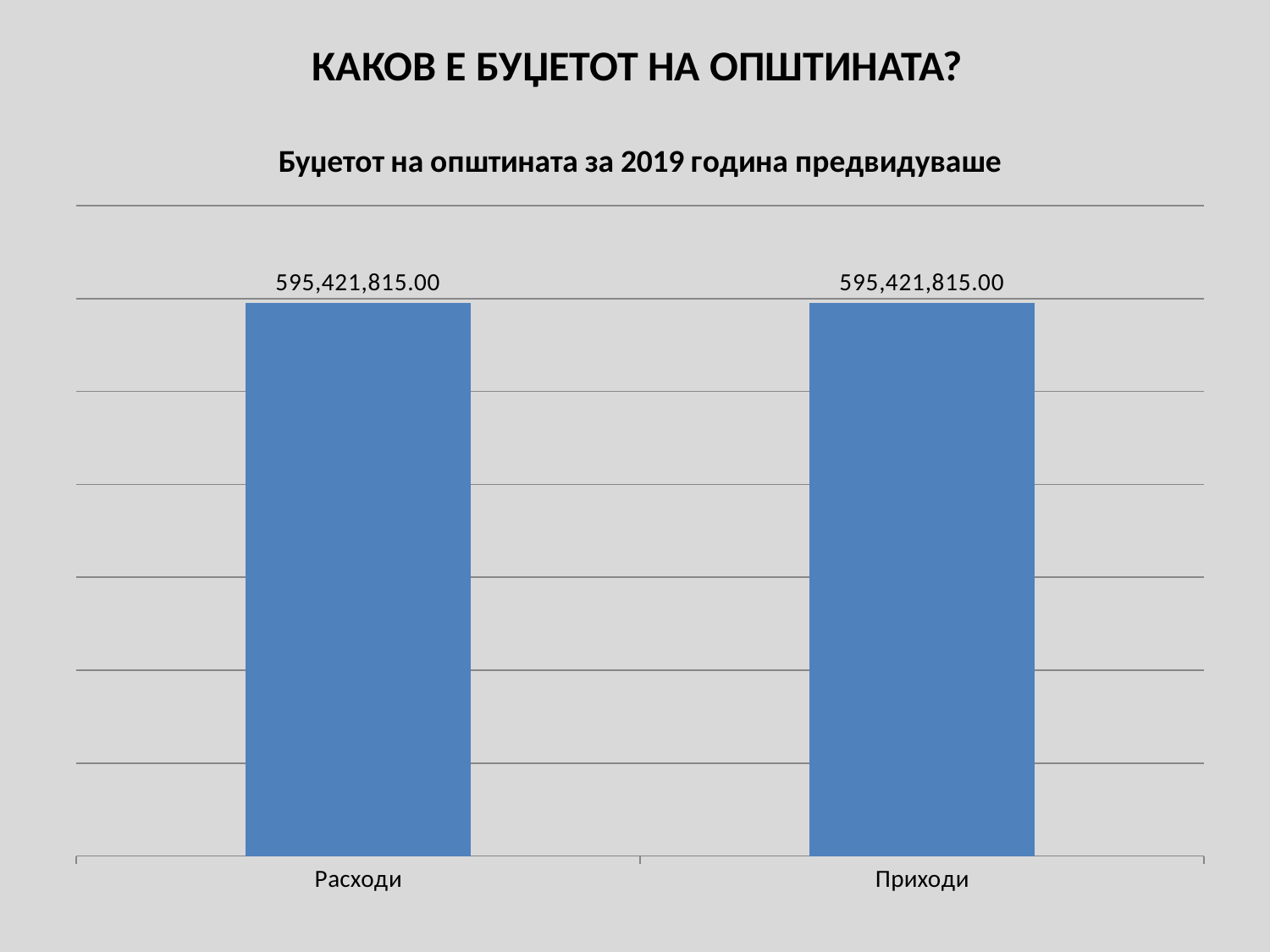
What is the difference between the values for Расходи and Приходи? 0.00 Is the value for Расходи greater than, less than, or equal to the value for Приходи? equal What is the title of the chart? Буџетот на општината за 2019 година предвидуваше What is the value for Расходи? 595,421,815.00 How many categories are shown on the x axis of the chart? 2 What kind of chart is shown on the slide? bar chart What colour are the bars in the chart? blue What is the value for Приходи? 595,421,815.00 Which category is listed first on the x axis? Расходи Which category is listed second on the x axis? Приходи